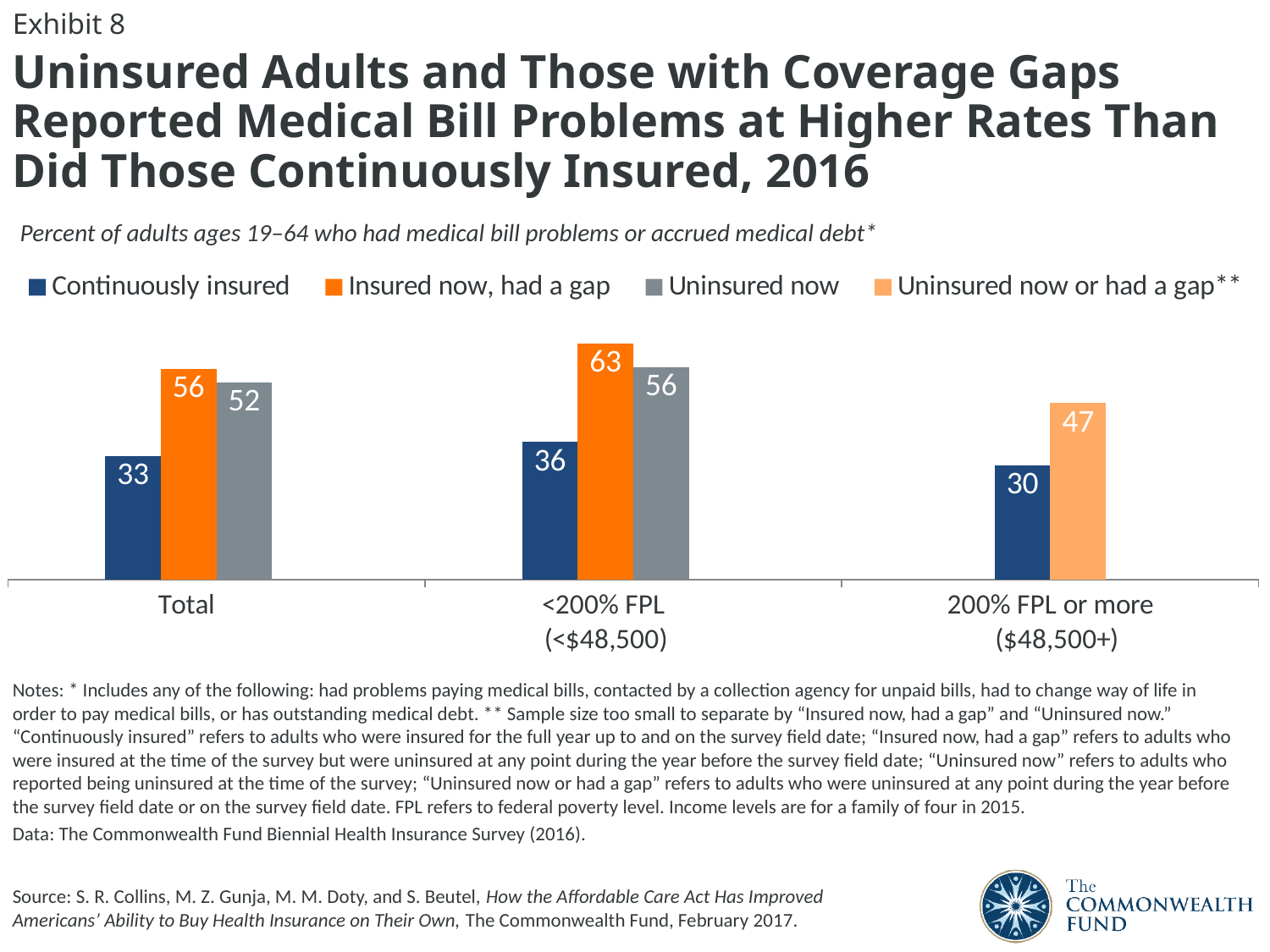
What is the difference between Insured now, had a gap and Continuously insured in the Total category? 23 What is the value for Insured now, had a gap in the <200% FPL category? 63 Which is larger: Uninsured now in the Total category or Uninsured now in the <200% FPL category? <200% FPL What is the value for Uninsured now in the Total category? 52 Which series has the highest value in the <200% FPL category? Insured now, had a gap How many series does the legend list? 4 What colour represents the Insured now, had a gap series? Orange What is the value for Continuously insured in the Total category? 33 What is the value for Uninsured now or had a gap in the 200% FPL or more category? 47 What kind of chart is shown on the slide? Bar chart How many categories are shown on the x axis? 3 Which category has the lowest value for Continuously insured? 200% FPL or more